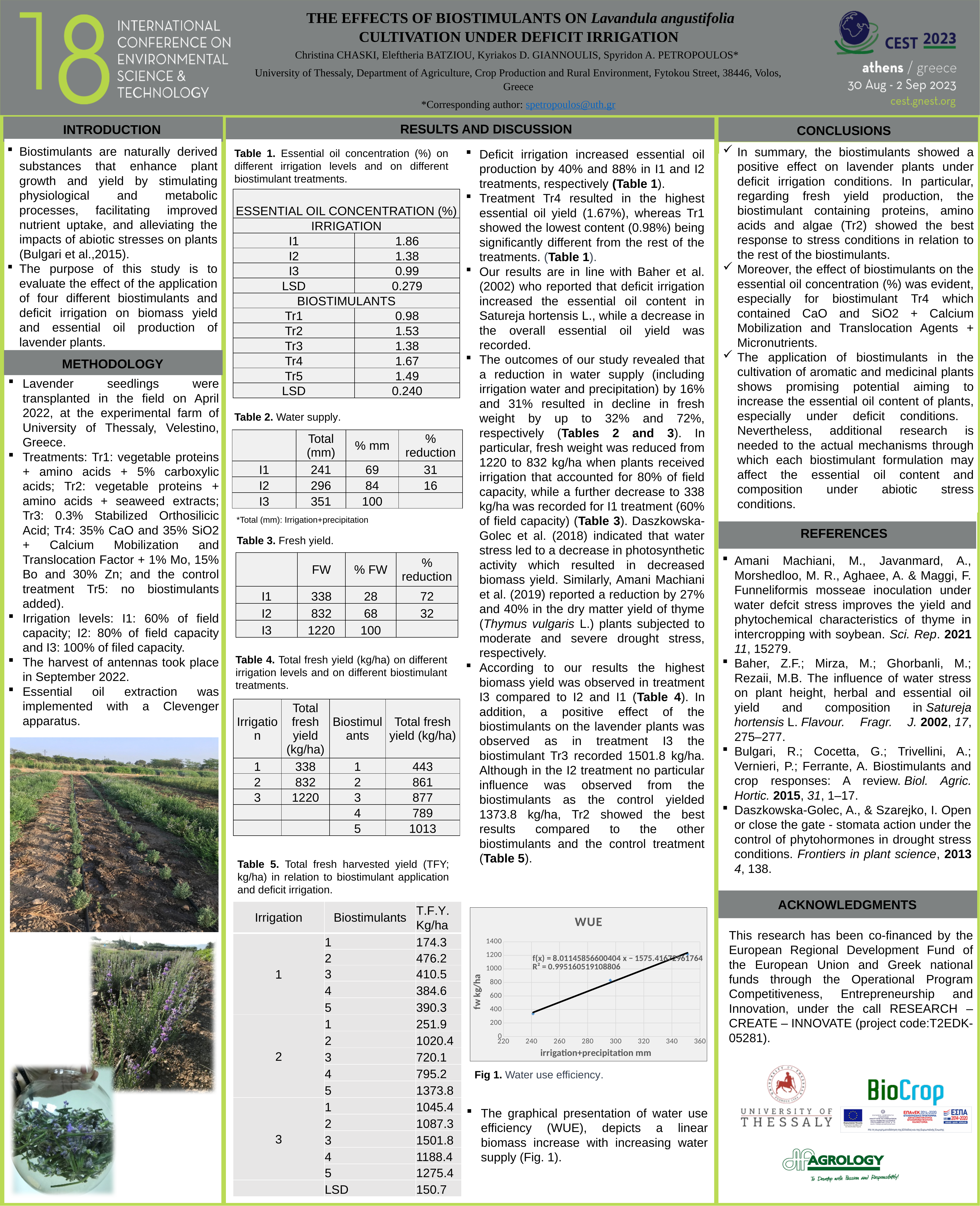
How many data points are plotted in the WUE chart? 3 What kind of chart is the WUE chart on the slide? scatter chart In the WUE chart, is the fw kg/ha value for the point near 240 mm greater or less than 400? less In the WUE chart, is the fw kg/ha value at the point near 240 mm larger or smaller than at the point near 350 mm? smaller In the WUE chart, is the fw kg/ha value for the point near 350 mm greater or less than 1000? greater In the WUE chart, is the highest fw kg/ha value found at the lowest or the highest irrigation+precipitation value? highest In the WUE chart, does fw kg/ha rise or fall as irrigation+precipitation mm increases? rise In the WUE chart, is the fw kg/ha value for the point near 300 mm greater or less than 600? greater What R² value is printed on the WUE chart? 0.995160519108806 What is the title of the chart on the slide? WUE